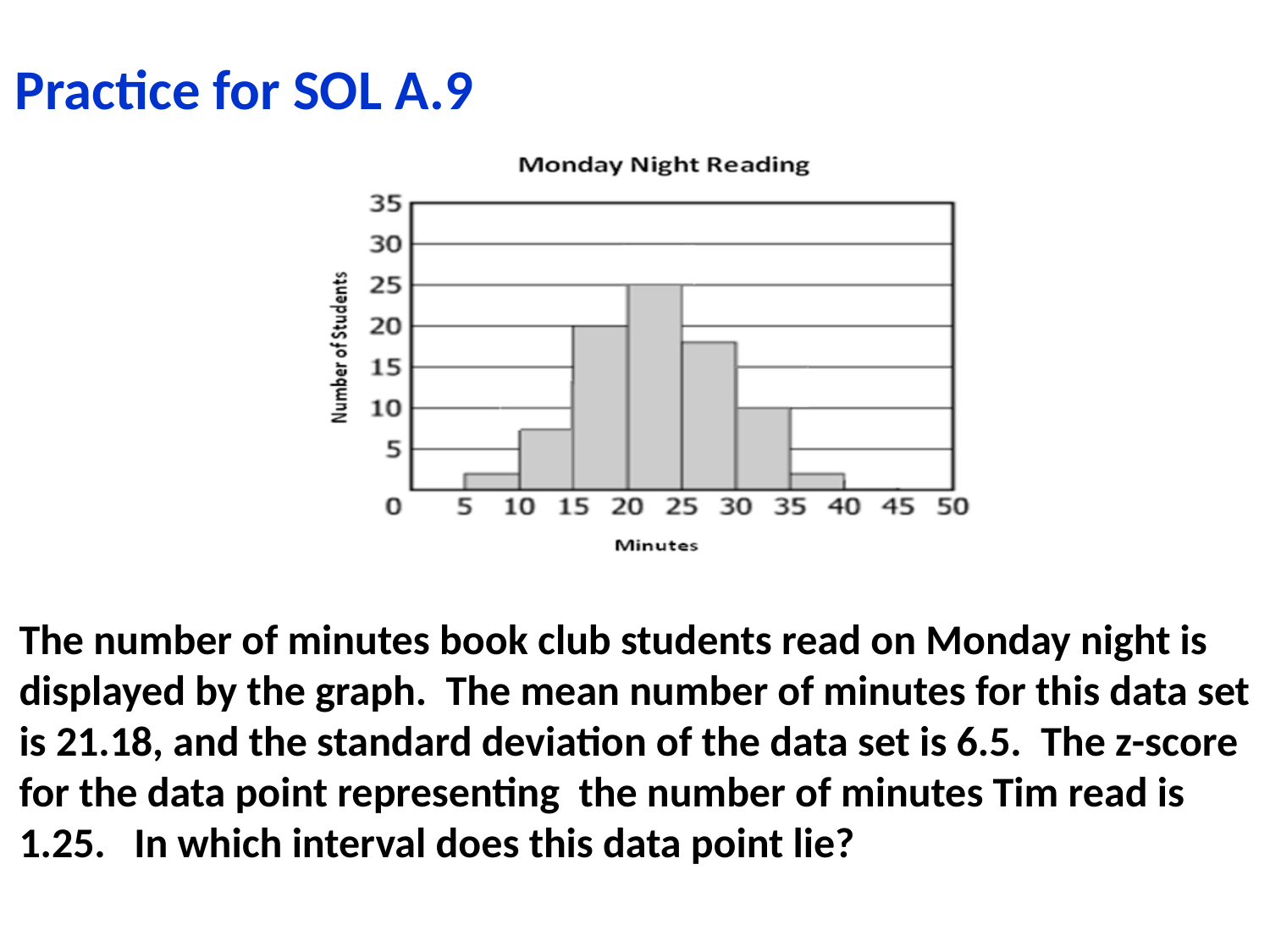
How many students read for 20 to 25 minutes according to the Monday Night Reading chart? 25 What kind of chart is shown on the slide? bar chart Is the number of students in the 10 to 15 minute interval greater or less than 10? less Is the number of students in the 5 to 10 minute interval greater or less than 5? less Which minutes interval has the highest number of students? 20 to 25 minutes Which interval has more students: 15 to 20 minutes or 30 to 35 minutes? 15 to 20 minutes How many students read for 30 to 35 minutes? 10 Is the number of students in the 25 to 30 minute interval greater or less than 15? greater How many students read for 15 to 20 minutes? 20 How many bars are shown in the Monday Night Reading chart? 7 What is the label on the vertical axis of the chart? Number of Students What is the difference between the number of students in the 20 to 25 minute interval and the 30 to 35 minute interval? 15